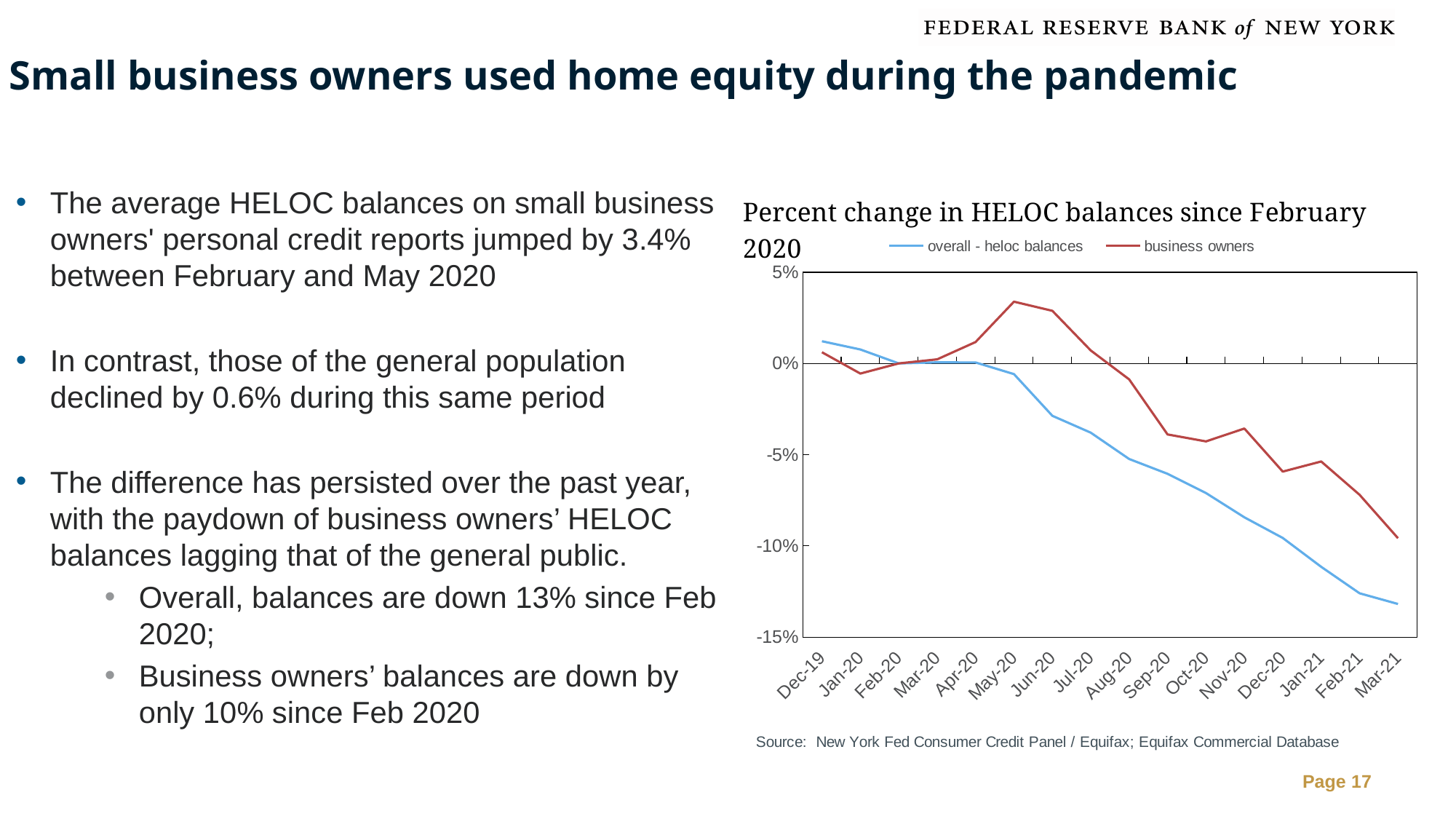
Does the 'overall - heloc balances' series rise or fall from Dec-19 to Mar-21? fall What colour is the line for the 'business owners' series? red How many months are plotted along the x axis of the chart? 16 In which month does the 'business owners' series reach its highest value? May-20 What kind of chart is shown on the slide? line chart Is the value for 'business owners' in May-20 greater or less than 0%? greater Is the value for 'business owners' in Mar-21 greater or less than -5%? less Is the value for 'overall - heloc balances' in Mar-21 greater or less than -10%? less In which month does the 'overall - heloc balances' series reach its lowest value? Mar-21 In Mar-21, which series has the larger value: 'overall - heloc balances' or 'business owners'? business owners In Jun-20, which series has the larger value: 'overall - heloc balances' or 'business owners'? business owners How many series does the chart legend list? 2